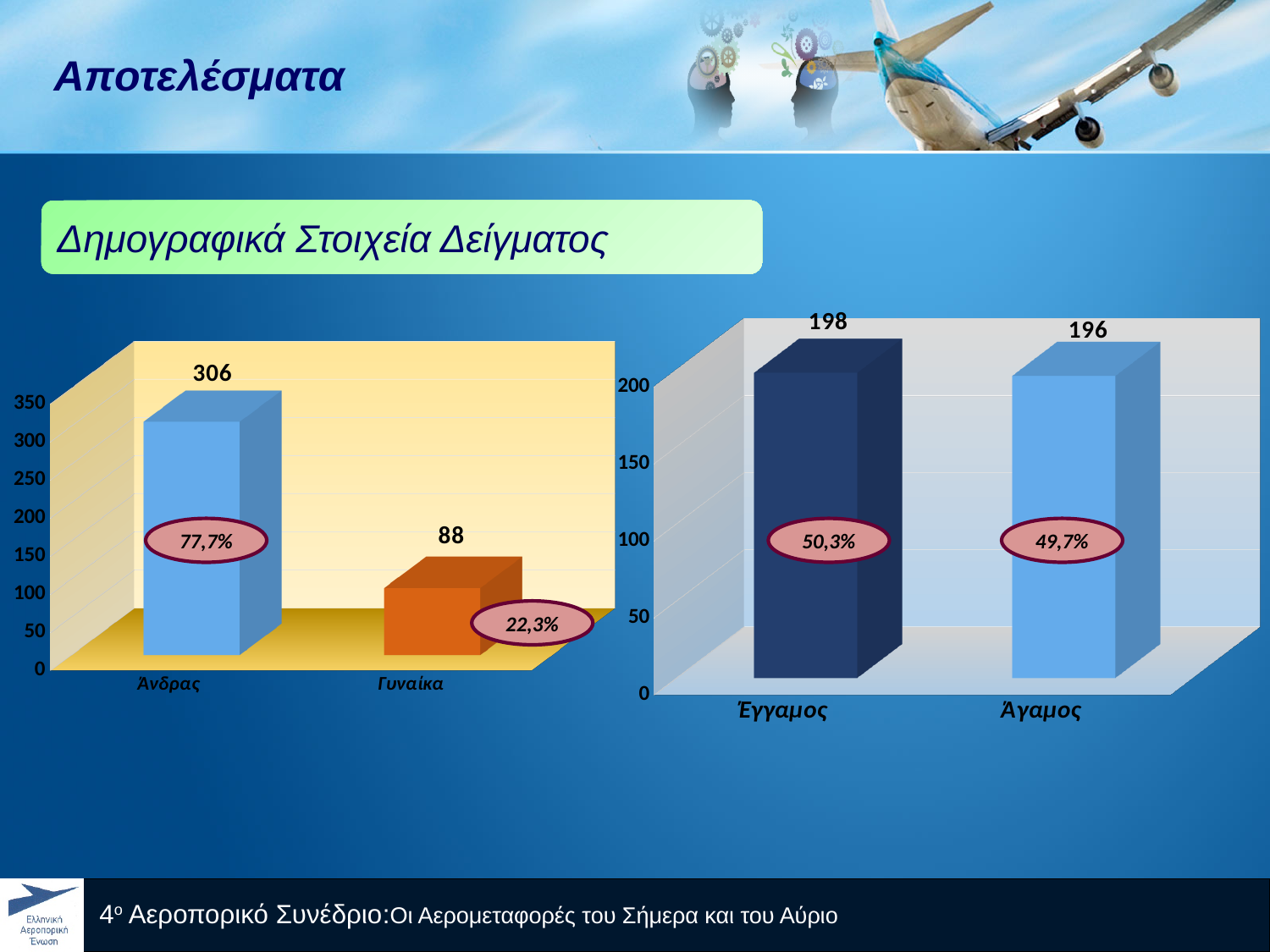
In the left chart, what percentage is shown for Γυναίκα? 22,3% What kind of chart is the right chart? bar chart In the left chart, how many categories are shown? 2 In the left chart, which category has the highest value? Άνδρας In the left chart, what is the value for Άνδρας? 306 In the left chart, what is the value for Γυναίκα? 88 In the right chart, what is the difference between the values for Έγγαμος and Άγαμος? 2 In the right chart, what percentage is shown for Άγαμος? 49,7% In the right chart, what is the value for Άγαμος? 196 In the left chart, what percentage is shown for Άνδρας? 77,7% In the left chart, what is the difference between the values for Άνδρας and Γυναίκα? 218 In the right chart, what is the value for Έγγαμος? 198